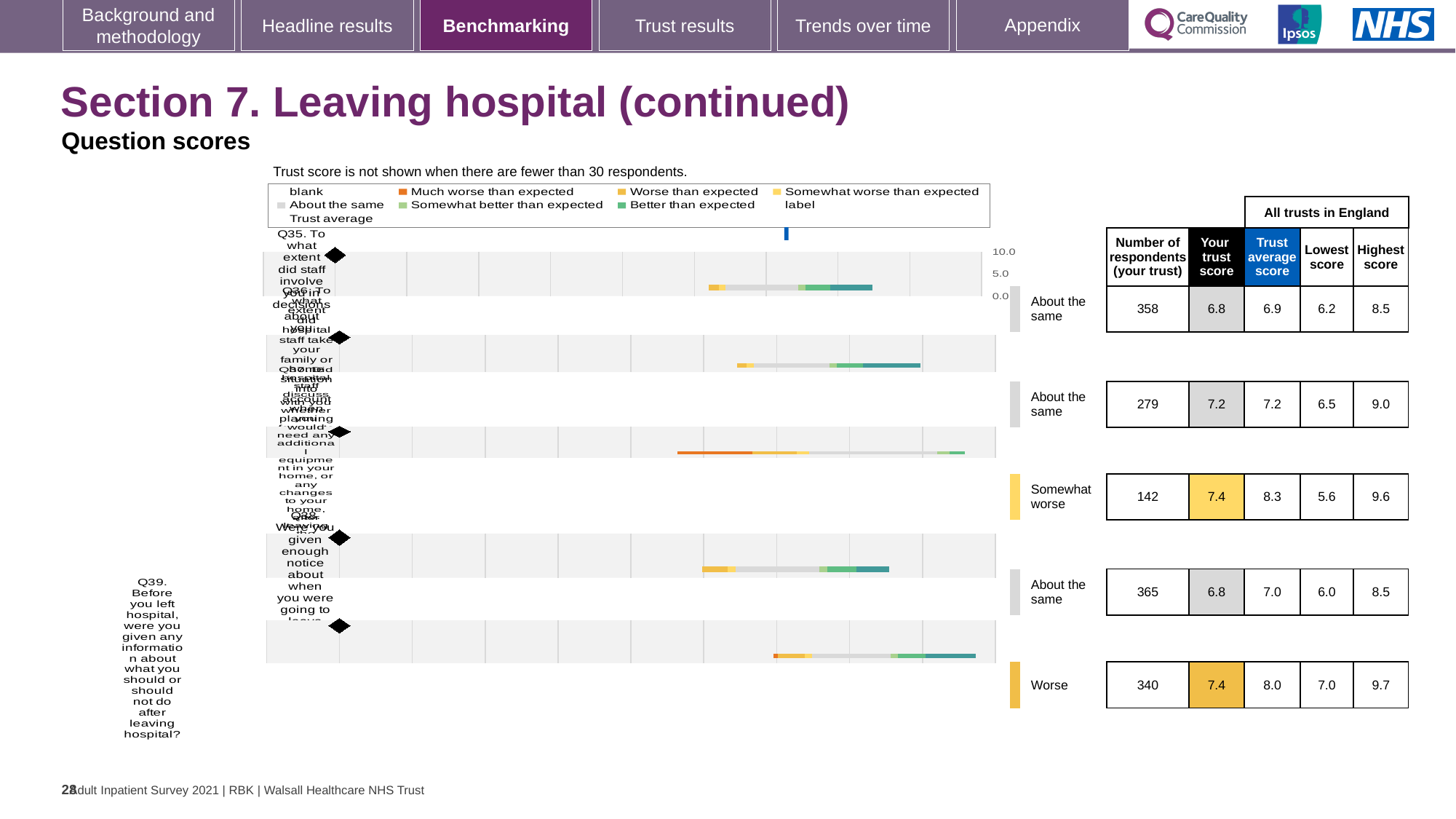
Which question row has the fewest respondents at this trust? The third row (142 respondents) Which question row has the highest 'Highest score' across all trusts in England? The last row, Q39 (9.7) What is the difference between the trust average score and this trust's score for Q39? 0.6 What is the trust average score for the first question row (Q35)? 6.9 How many respondents answered Q35 (staff involving you in decisions about leaving hospital) at this trust? 358 How many question rows are shown in the chart? 5 How many respondents answered Q39 at this trust? 340 What kind of chart is used to show the question scores? Bar chart What is the trust score for Q39 (information about what you should or should not do after leaving hospital)? 7.4 Which question row is rated 'Worse' compared with other trusts? The last row, Q39 For Q39, which is larger: this trust's score or the trust average score? Trust average score (8.0) What is the highest score across all trusts in England for Q39? 9.7